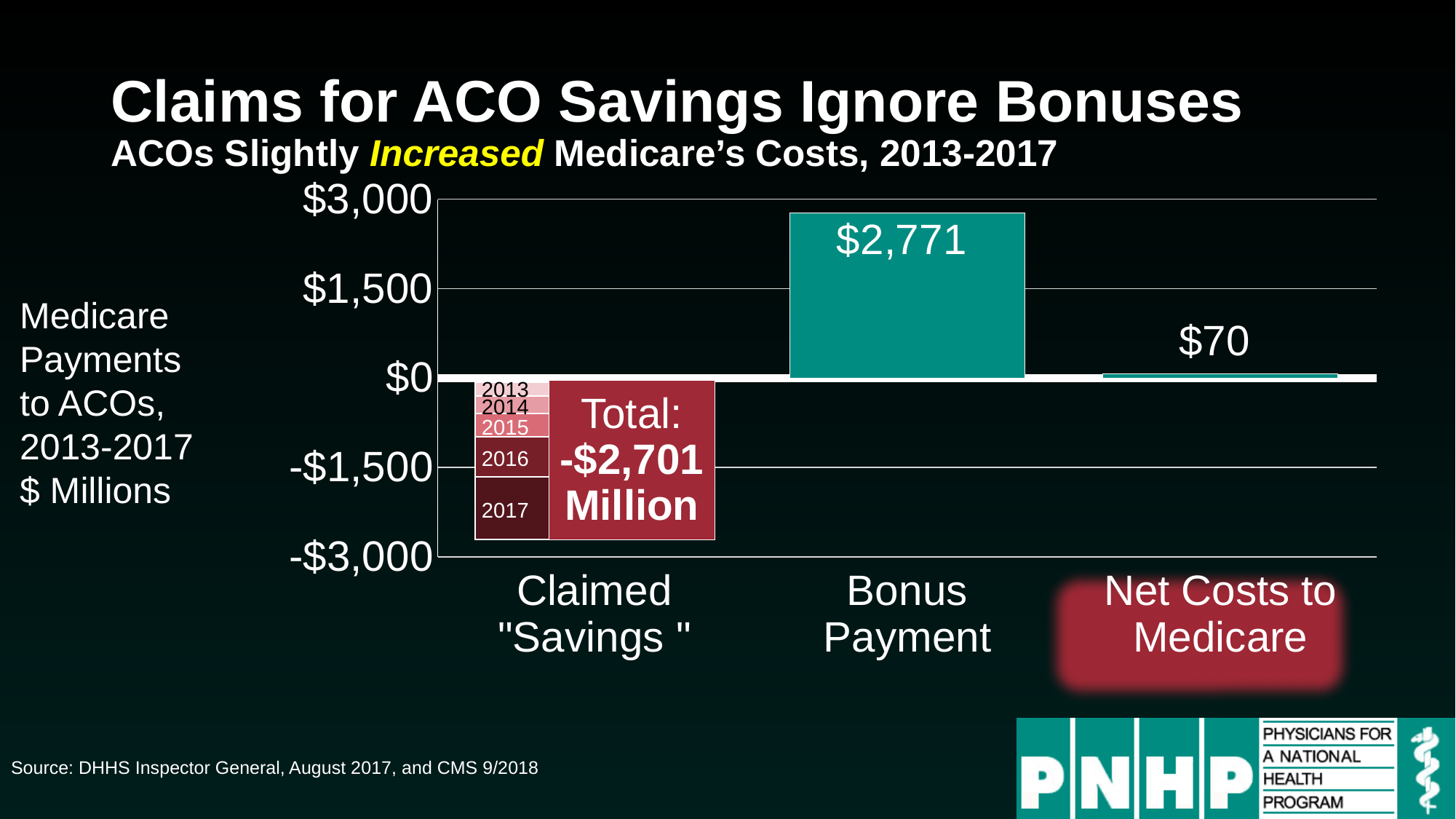
What is the value shown for Net Costs to Medicare? $70 How many years are labelled within the stacked Claimed "Savings" bar? 5 Is the value for Bonus Payment greater or less than $1,500? greater What kind of chart is shown on the slide? bar chart What total is printed on the Claimed "Savings" bar? -$2,701 Million Which category has the lowest value? Claimed "Savings" What is the difference between the Bonus Payment value and the Net Costs to Medicare value? $2,701 Which is larger, the value for Bonus Payment or the value for Net Costs to Medicare? Bonus Payment What is the highest value labelled on the y axis? $3,000 How many categories are shown on the x axis? 3 What is the value shown for Bonus Payment? $2,771 Which category has the highest value? Bonus Payment